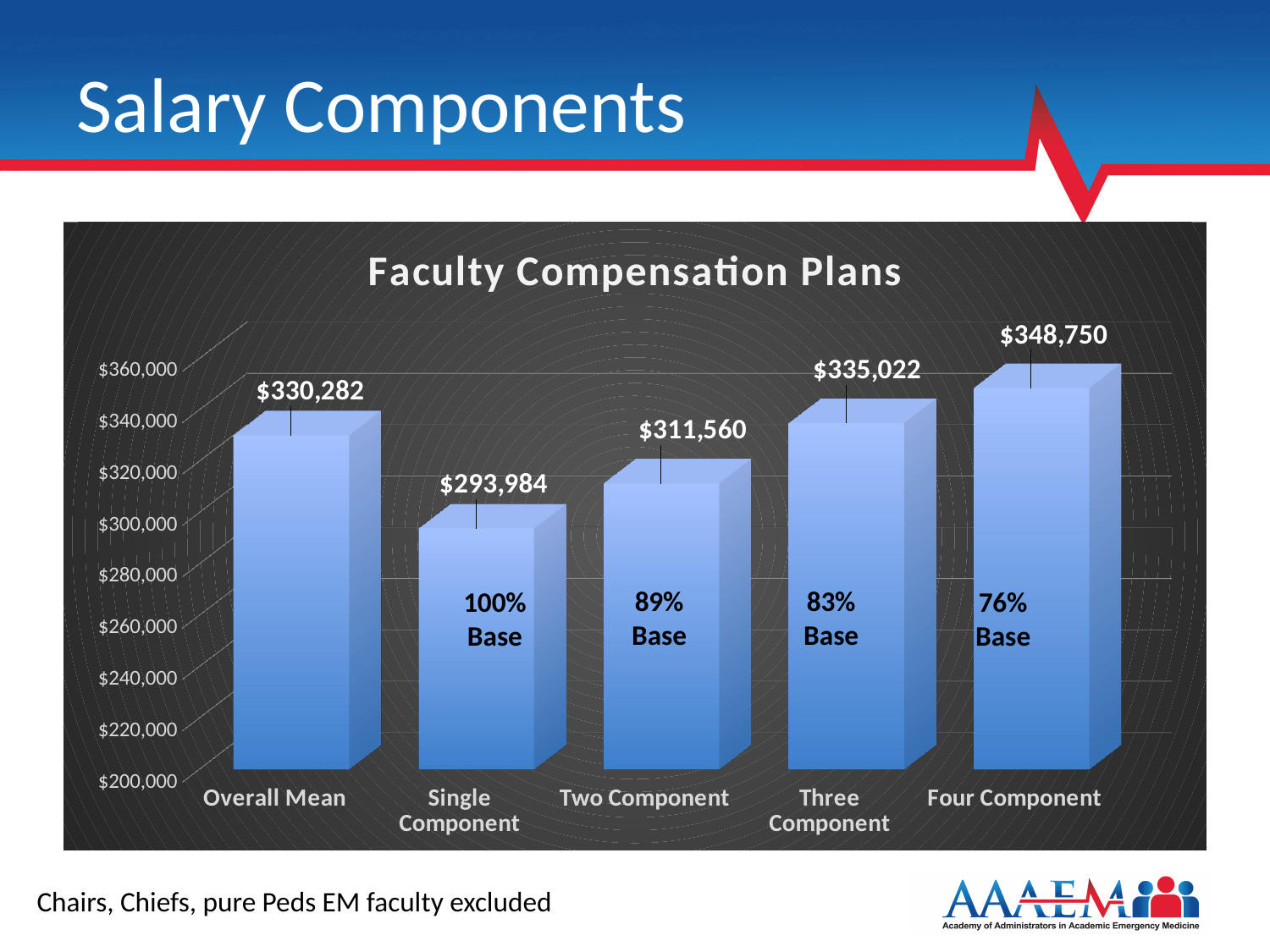
How many categories are shown in the Faculty Compensation Plans chart? 5 What is the value for Two Component in the Faculty Compensation Plans chart? $311,560 What base percentage is labelled on the Three Component bar? 83% Base Which is larger, the value for Three Component or the value for Overall Mean? Three Component What kind of chart is shown on the slide? Bar chart Which category has the lowest value in the Faculty Compensation Plans chart? Single Component What is the difference between the Three Component and Two Component values? $23,462 What is the value for Four Component in the Faculty Compensation Plans chart? $348,750 Which category has the highest value in the Faculty Compensation Plans chart? Four Component What is the difference between the Four Component and Single Component values? $54,766 What is the value for Single Component in the Faculty Compensation Plans chart? $293,984 What is the value for Overall Mean in the Faculty Compensation Plans chart? $330,282